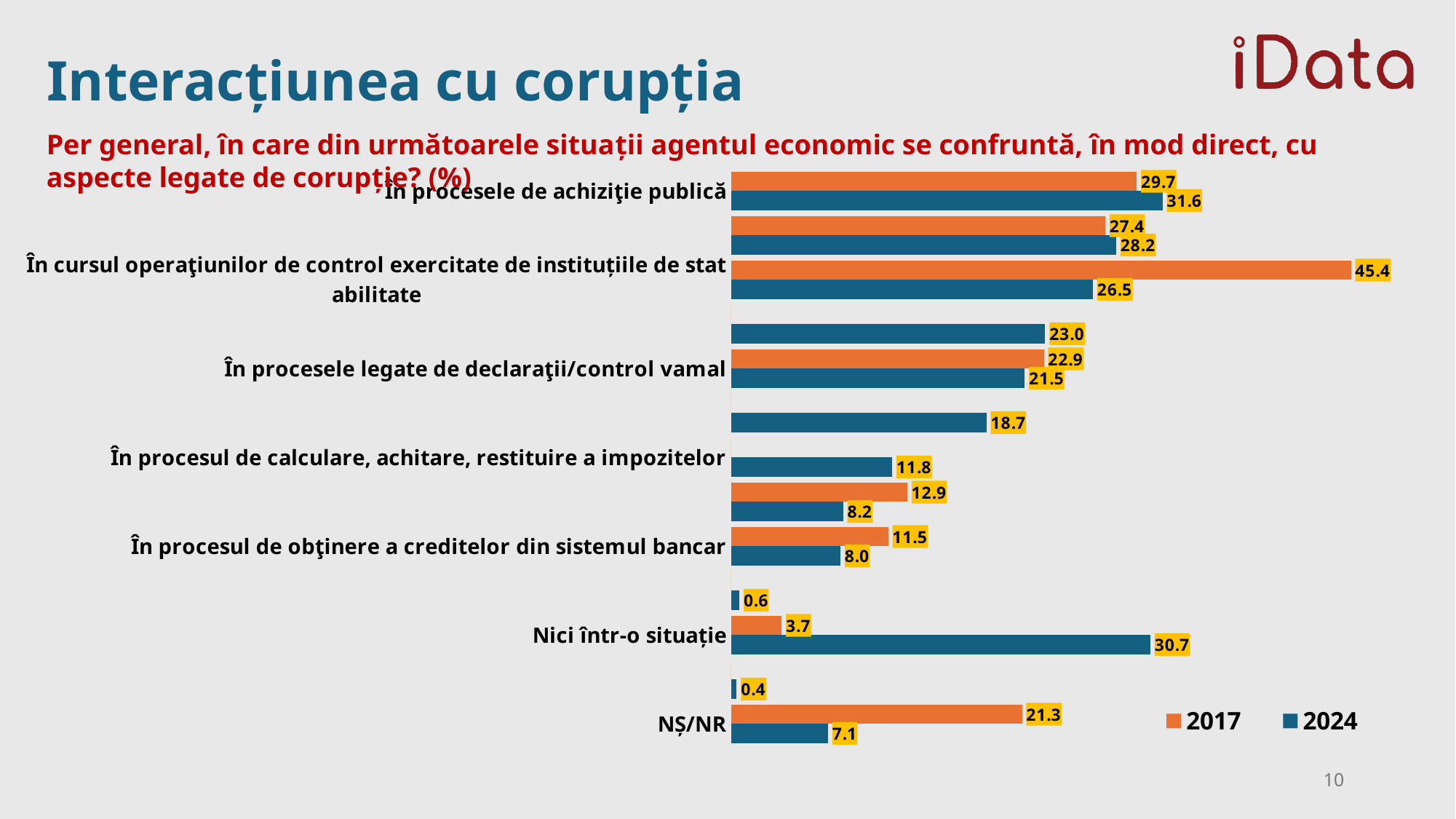
How many series does the legend list? 2 What kind of chart is shown on the slide? bar chart What is the highest value labelled anywhere on the chart? 45.4 What is the 2017 value for 'NȘ/NR'? 21.3 What is the lowest value labelled anywhere on the chart? 0.4 What is the difference between the 2017 and 2024 values for 'NȘ/NR'? 14.2 For 'Nici într-o situație', which year has the larger value, 2017 or 2024? 2024 What is the 2017 value for 'În cursul operaţiunilor de control exercitate de instituțiile de stat abilitate'? 45.4 Which two years are listed in the chart legend? 2017 and 2024 What is the 2017 value for 'În procesele de achiziţie publică'? 29.7 What is the 2024 value for 'În procesele de achiziţie publică'? 31.6 What is the 2024 value for 'Nici într-o situație'? 30.7